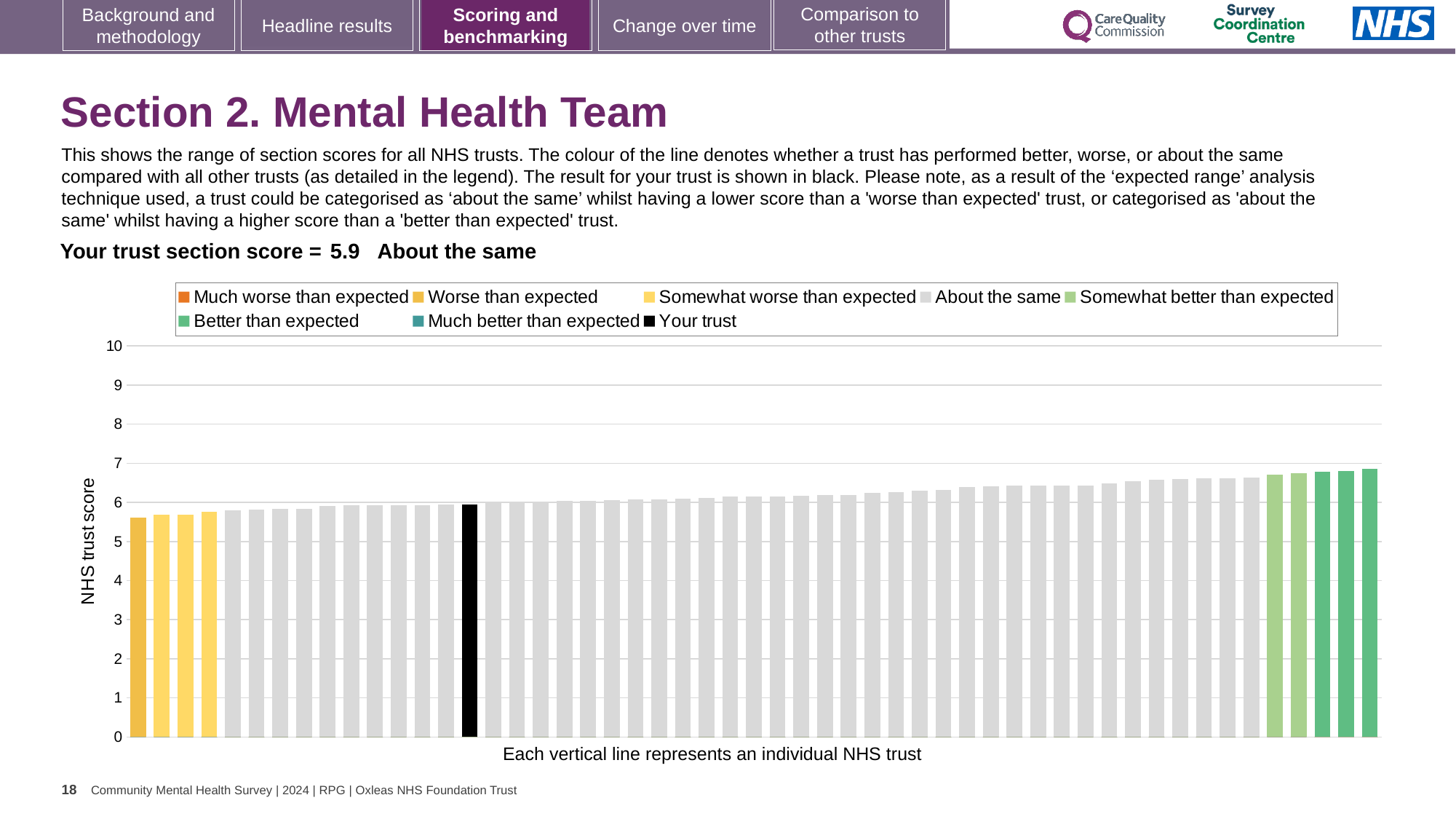
What kind of chart is shown on the slide? bar chart What colour is the bar representing your trust? black What is the section score for your trust shown on the slide? 5.9 Is the value of the black bar (your trust) greater or less than 7? less Which benchmarking category is your trust placed in for this section? About the same Is the value of the shortest bar greater or less than 5? greater Is the value of the tallest bar greater or less than 7? less What is the label on the vertical axis of the chart? NHS trust score How many entries does the chart legend list? 8 Do the bar values rise or fall from left to right along the x axis? rise